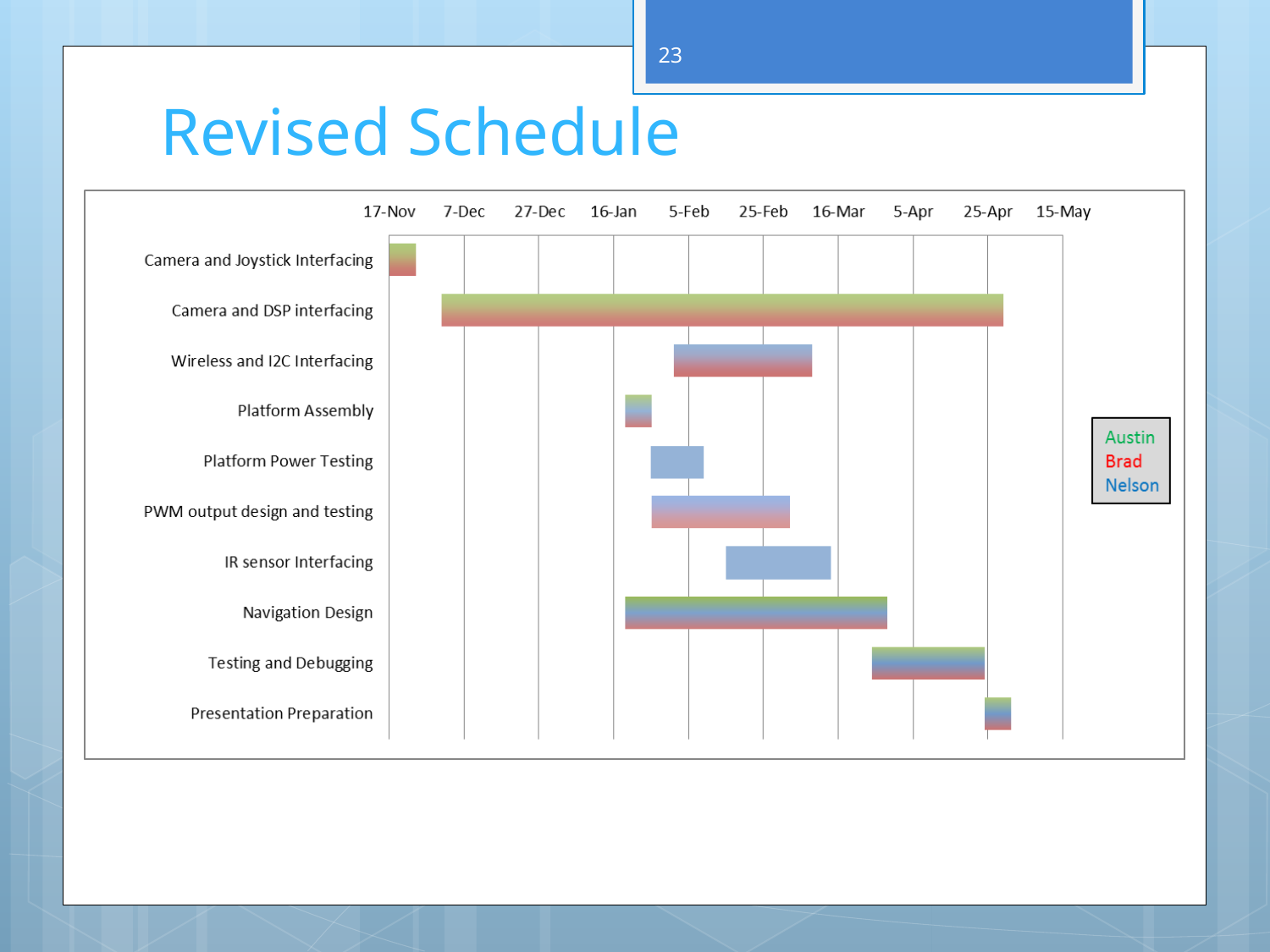
What is the title of the slide containing the schedule chart? Revised Schedule Which task starts latest in the schedule chart? Presentation Preparation Which task has a longer bar, Camera and DSP interfacing or Wireless and I2C Interfacing? Camera and DSP interfacing What kind of chart is shown on the slide? Bar chart (Gantt chart) Does the Platform Power Testing bar start before or after 16-Jan? after Does the IR sensor Interfacing bar start before or after 5-Feb? after What three names appear in the legend box beside the schedule chart? Austin, Brad, Nelson Which task starts earliest in the schedule chart? Camera and Joystick Interfacing Which task has the longest bar in the schedule chart? Camera and DSP interfacing Does the Wireless and I2C Interfacing bar end before or after 16-Mar? before How many tasks are listed on the vertical axis of the schedule chart? 10